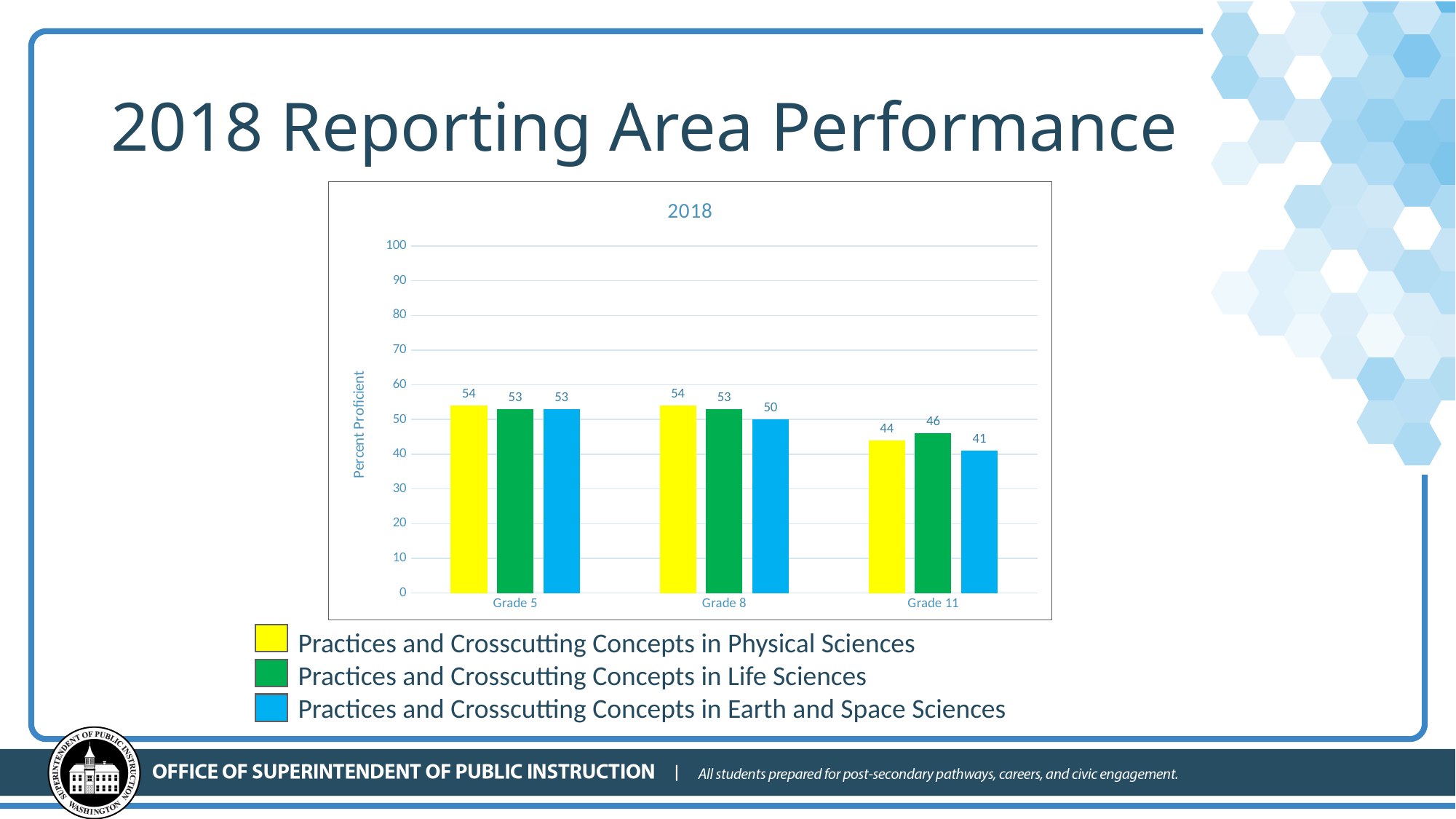
What is the label of the y axis? Percent Proficient What is the percent proficient for Practices and Crosscutting Concepts in Life Sciences in Grade 11? 46 What is the percent proficient for Practices and Crosscutting Concepts in Physical Sciences in Grade 5? 54 How many series does the legend list? 3 Which reporting area has the highest percent proficient in Grade 11? Practices and Crosscutting Concepts in Life Sciences What is the percent proficient for Practices and Crosscutting Concepts in Earth and Space Sciences in Grade 8? 50 Is the Grade 11 value for Practices and Crosscutting Concepts in Physical Sciences greater or less than 50? less Which grade has the lowest percent proficient for Practices and Crosscutting Concepts in Earth and Space Sciences? Grade 11 Which is larger: the Grade 8 value for Earth and Space Sciences or the Grade 11 value for Earth and Space Sciences? Grade 8 What is the difference in percent proficient between Grade 8 and Grade 11 for Practices and Crosscutting Concepts in Physical Sciences? 10 What kind of chart is shown on the slide? bar chart How many grade levels are shown on the x axis? 3